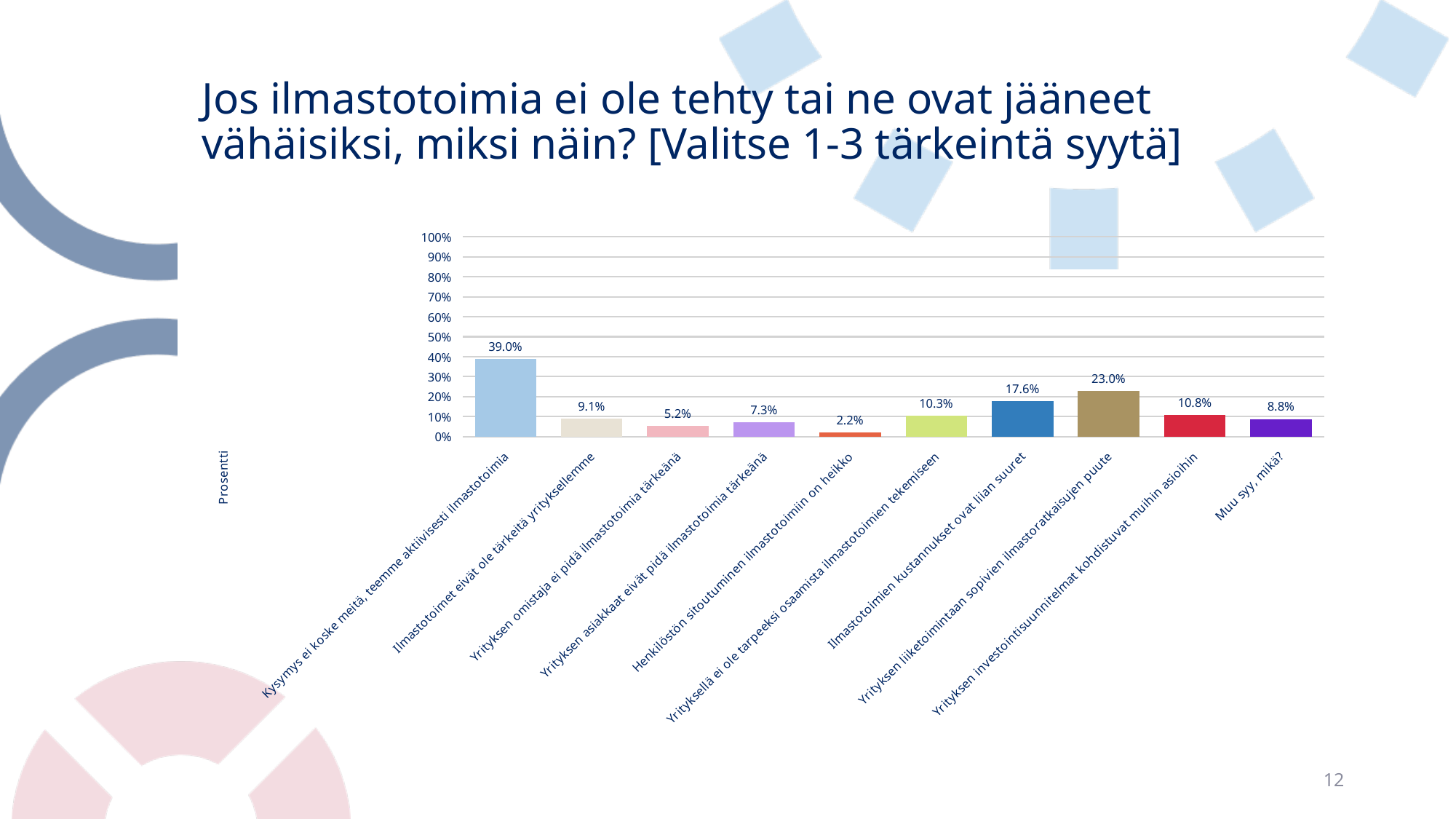
Which is larger: the value for "Yrityksen investointisuunnitelmat kohdistuvat muihin asioihin" or "Yrityksellä ei ole tarpeeksi osaamista ilmastotoimien tekemiseen"? Yrityksen investointisuunnitelmat kohdistuvat muihin asioihin What is the value for "Yrityksen liiketoimintaan sopivien ilmastoratkaisujen puute"? 23.0% What is the value for "Muu syy, mikä?"? 8.8% What is the value for "Ilmastotoimien kustannukset ovat liian suuret"? 17.6% Which category has the lowest value? Henkilöstön sitoutuminen ilmastotoimiin on heikko Is the value for "Ilmastotoimien kustannukset ovat liian suuret" greater or less than 20%? less What kind of chart is shown on the slide? bar chart How many categories are shown in the chart? 10 What is the difference between the values for "Kysymys ei koske meitä, teemme aktiivisesti ilmastotoimia" and "Yrityksen liiketoimintaan sopivien ilmastoratkaisujen puute"? 16.0% What is the value for "Yrityksen omistaja ei pidä ilmastotoimia tärkeänä"? 5.2% What is the label on the vertical axis of the chart? Prosentti Which category has the highest value? Kysymys ei koske meitä, teemme aktiivisesti ilmastotoimia